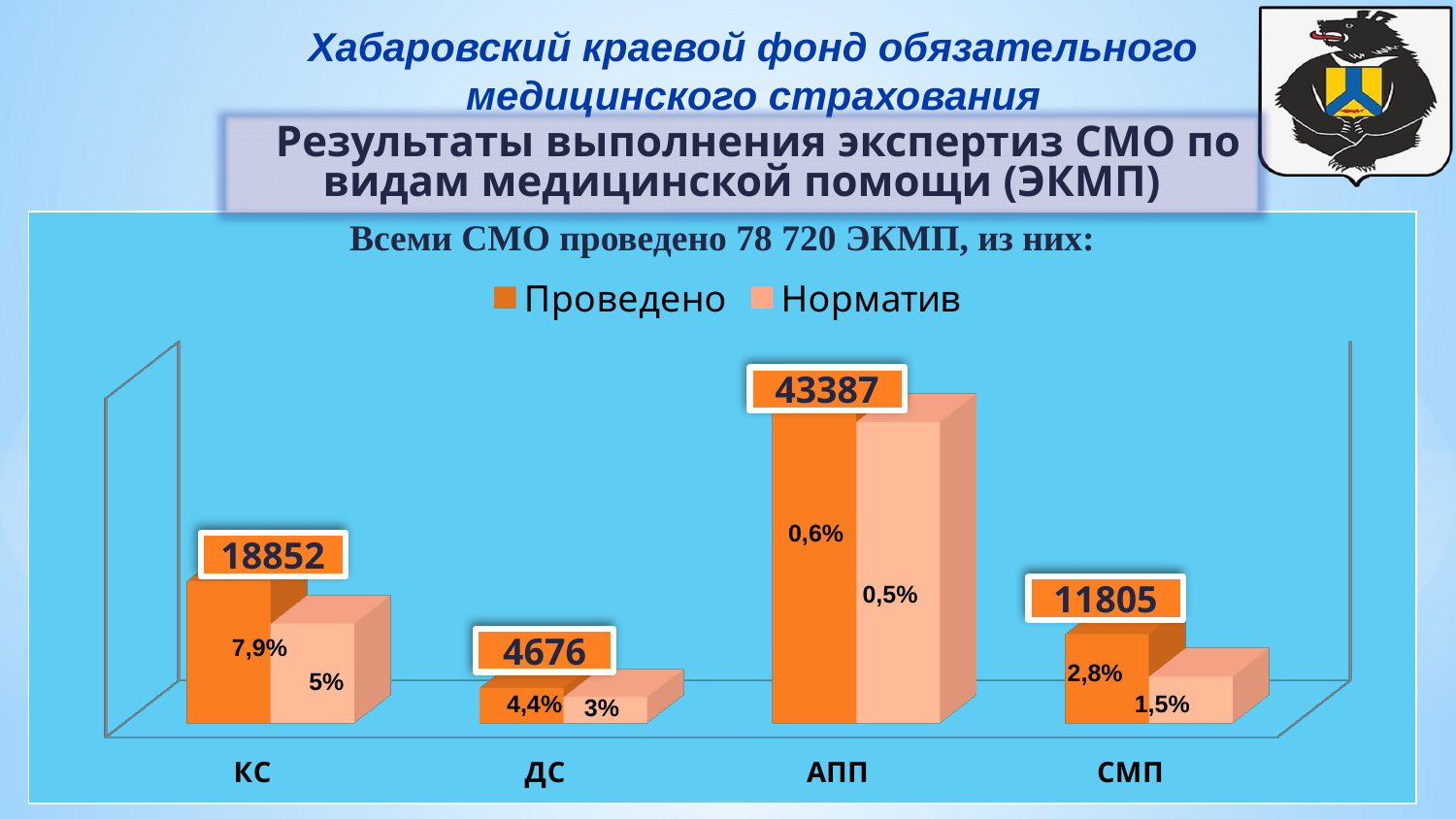
What is the number of ЭКМП shown for the Проведено bar in the СМП category? 11805 Which series is shown in the darker orange colour in the legend? Проведено What kind of chart is shown on the slide? bar chart How many categories are shown on the x axis of the chart? 4 Which category has the lowest Проведено value? ДС What is the difference between the Проведено values for КС and СМП? 7047 What is the number of ЭКМП shown for the Проведено bar in the АПП category? 43387 What percentage label is shown on the Проведено bar for СМП? 2,8% What is the number of ЭКМП shown for the Проведено bar in the ДС category? 4676 What percentage label is shown on the Норматив bar for КС? 5% Which category has the highest Проведено value? АПП How many series does the chart legend list? 2